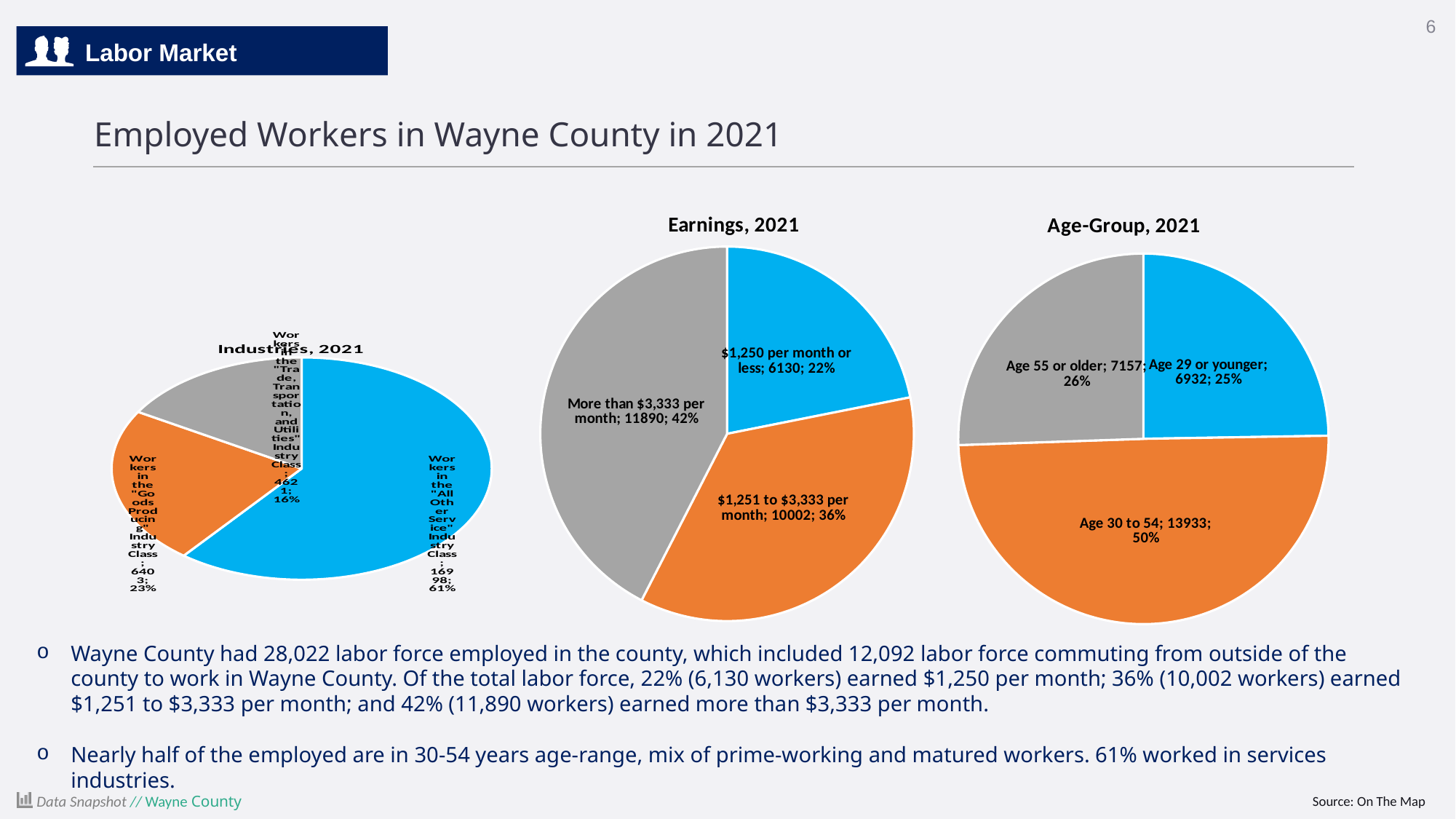
In the Industries, 2021 chart, what share of workers are in the "All Other Service" Industry Class? 61% In the Age-Group, 2021 chart, which group has more workers: Age 55 or older or Age 29 or younger? Age 55 or older What type of chart is the Age-Group, 2021 chart? Pie chart In the Earnings, 2021 chart, how many workers earned $1,250 per month or less? 6130 In the Age-Group, 2021 chart, how many workers are aged 30 to 54? 13933 How many slices does the Earnings, 2021 pie chart have? 3 In the Age-Group, 2021 chart, what share of workers are age 55 or older? 26% In the Industries, 2021 chart, how many workers are in the "Goods Producing" Industry Class? 6403 In the Earnings, 2021 chart, what share of workers earned more than $3,333 per month? 42% In the Earnings, 2021 chart, what is the difference in workers between the $1,251 to $3,333 per month group and the $1,250 per month or less group? 3872 In the Earnings, 2021 chart, which earnings category has the largest number of workers? More than $3,333 per month In the Age-Group, 2021 chart, which age group has the fewest workers? Age 29 or younger